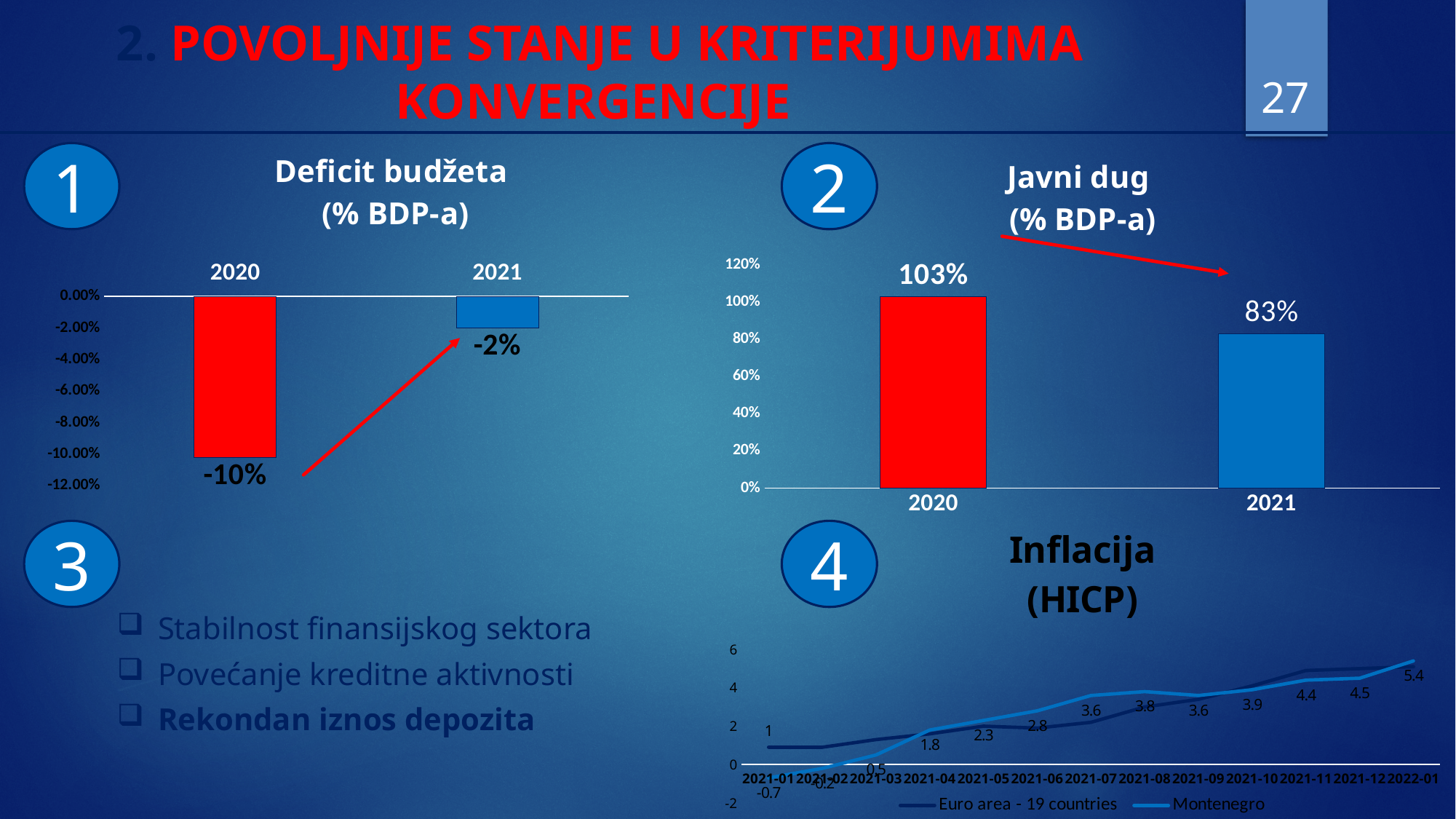
How many series does the legend of the 'Inflacija (HICP)' chart list? 2 In the 'Deficit budžeta (% BDP-a)' chart, what is the value for 2021? -2% In the 'Javni dug (% BDP-a)' chart, which year has the higher value? 2020 What kind of chart is the 'Inflacija (HICP)' chart? line chart In the 'Javni dug (% BDP-a)' chart, what is the value for 2020? 103% In the 'Inflacija (HICP)' chart, do the values generally rise or fall from 2021-01 to 2022-01? rise What kind of chart is the 'Javni dug (% BDP-a)' chart? bar chart In the 'Javni dug (% BDP-a)' chart, what is the value for 2021? 83% In the 'Javni dug (% BDP-a)' chart, is the value for 2021 greater or less than 100%? less In the 'Deficit budžeta (% BDP-a)' chart, how many years are shown? 2 In the 'Javni dug (% BDP-a)' chart, what is the difference between the 2020 and 2021 values? 20% In the 'Deficit budžeta (% BDP-a)' chart, what is the value for 2020? -10%